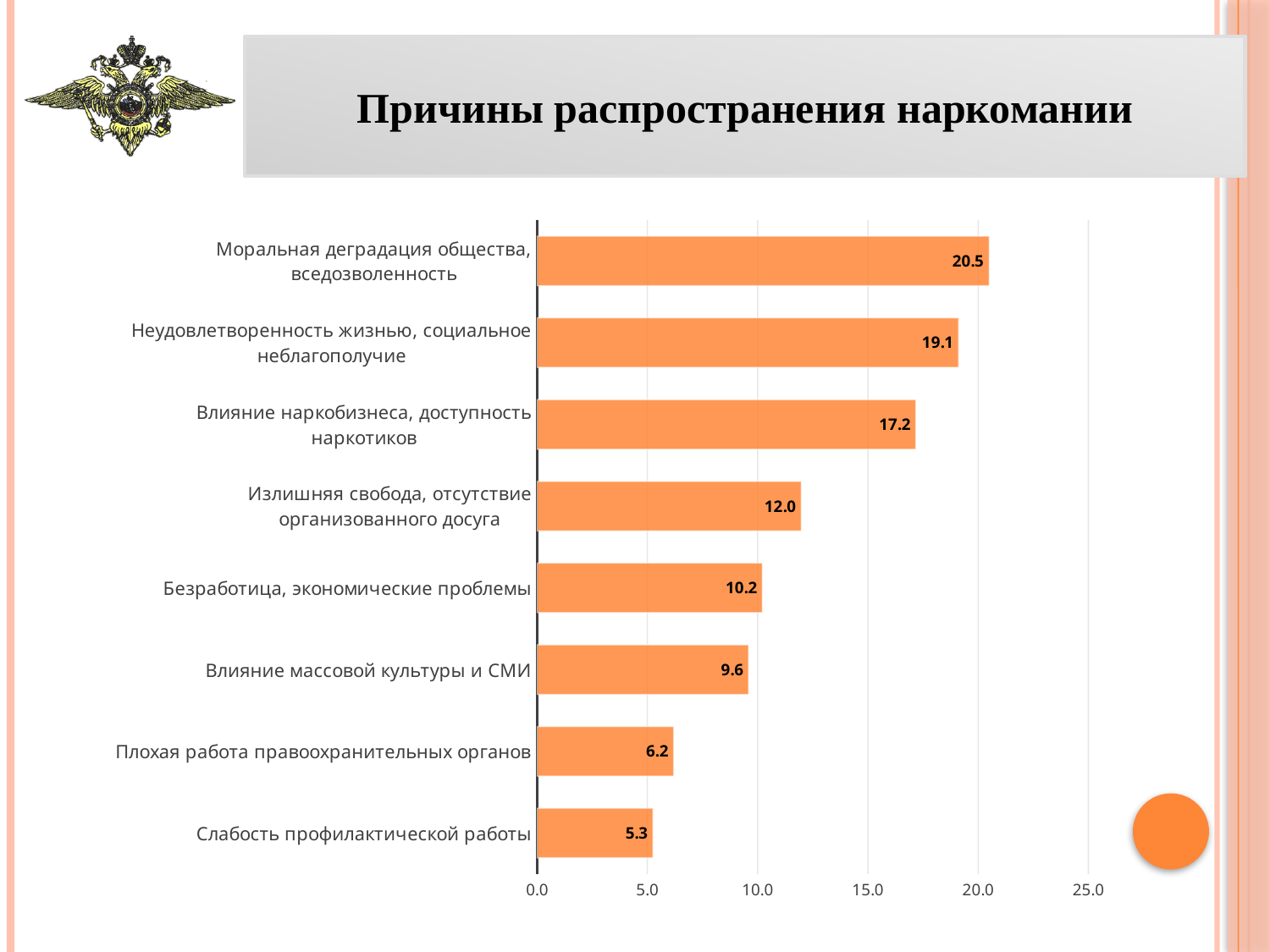
Is the value for "Плохая работа правоохранительных органов" greater or less than 10.0? less What is the value for "Безработица, экономические проблемы"? 10.2 Which category has the lowest value? Слабость профилактической работы What is the difference between the values for "Неудовлетворенность жизнью, социальное неблагополучие" and "Влияние наркобизнеса, доступность наркотиков"? 1.9 What is the title of the slide? Причины распространения наркомании How many categories are shown in the chart? 8 Which category has the highest value? Моральная деградация общества, вседозволенность What is the difference between the highest and lowest values in the chart? 15.2 What kind of chart is shown on the slide? bar chart What is the value for "Слабость профилактической работы"? 5.3 Which is larger: the value for "Излишняя свобода, отсутствие организованного досуга" or for "Влияние массовой культуры и СМИ"? Излишняя свобода, отсутствие организованного досуга What is the value for "Моральная деградация общества, вседозволенность"? 20.5